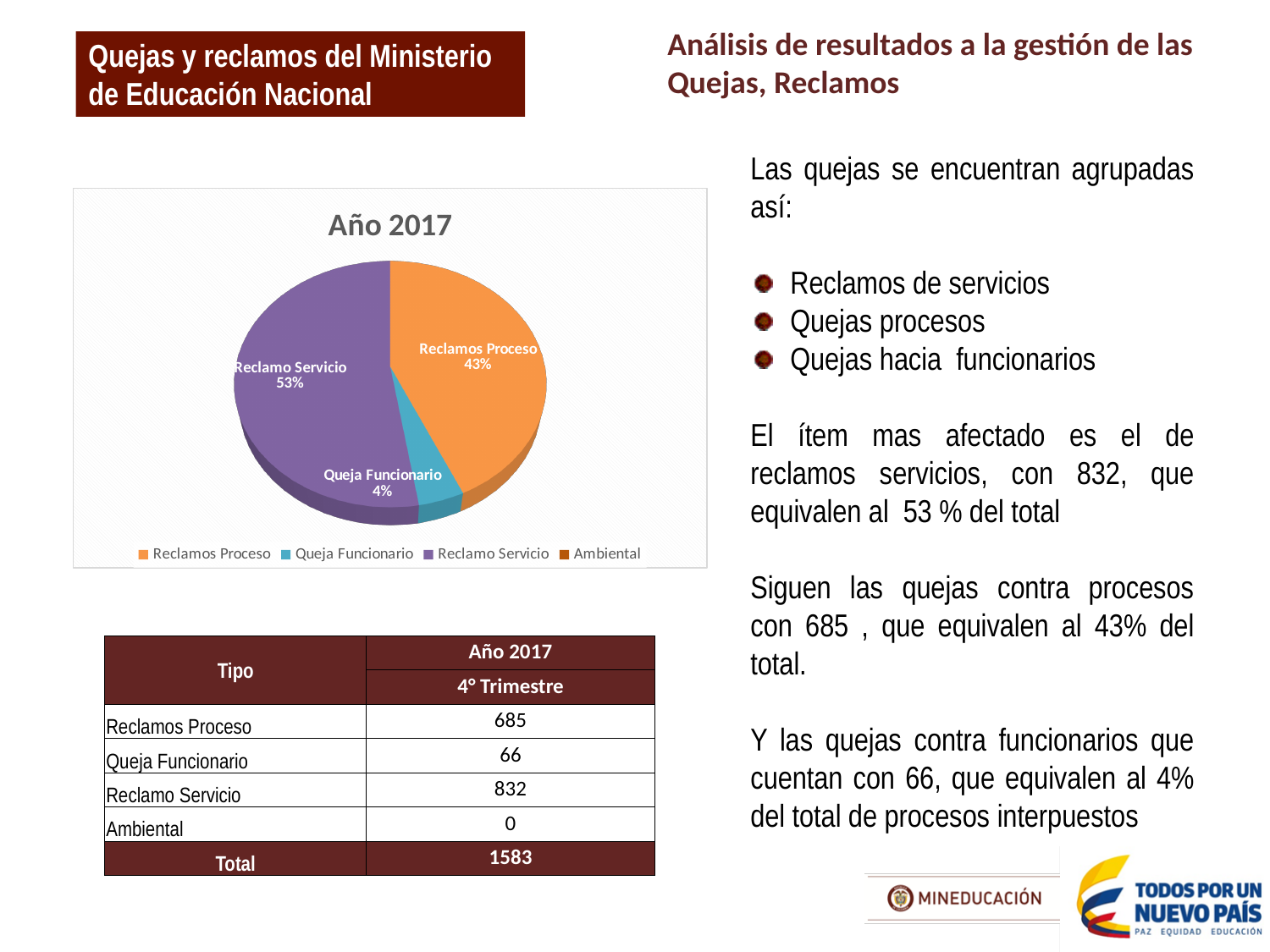
What share of the pie does Reclamos Proceso represent? 43% What is the difference in percentage points between the Reclamo Servicio and Reclamos Proceso slices? 10 percentage points Is the share for Reclamo Servicio greater or less than 50%? greater Which of the labeled slices is the smallest? Queja Funcionario Which slice is larger, Reclamos Proceso or Queja Funcionario? Reclamos Proceso What is the title of the chart? Año 2017 Which category has the largest slice of the pie? Reclamo Servicio What share of the pie does Queja Funcionario represent? 4% How many categories does the chart legend list? 4 What kind of chart is shown on the slide? pie chart What share of the pie does Reclamo Servicio represent? 53% Which legend entry has no visible slice in the pie? Ambiental